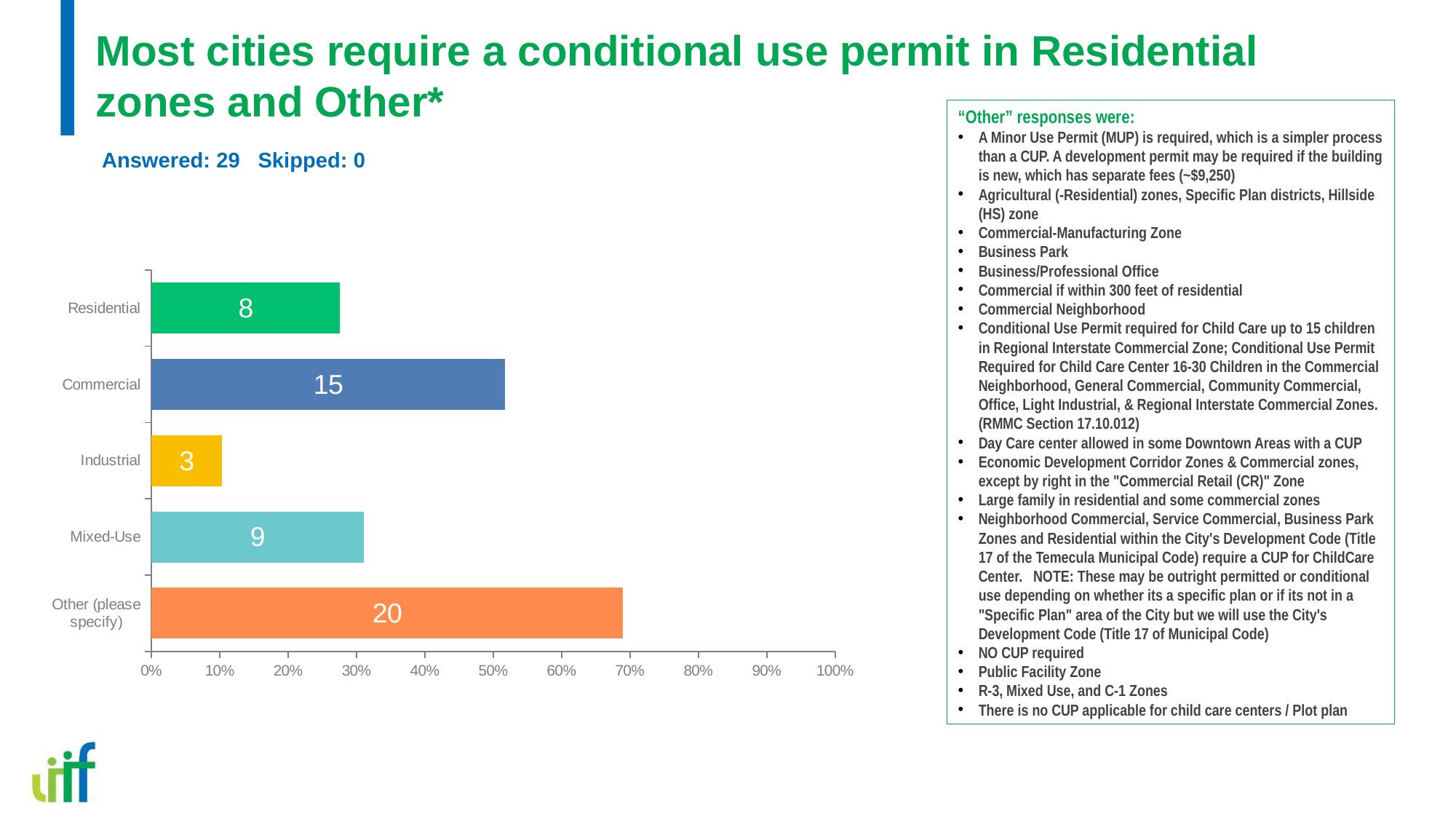
Is the Industrial bar greater or less than 20% on the axis? less What is the data label on the Commercial bar? 15 Is the Commercial bar greater or less than 50% on the axis? greater Which category has the lowest value? Industrial What is the difference between the Commercial and Residential data labels? 7 What is the data label on the Industrial bar? 3 What kind of chart is shown on the slide? Bar chart How many categories are shown in the chart? 5 Which category has the highest value? Other (please specify) Which is larger, the Mixed-Use bar or the Residential bar? Mixed-Use What is the data label on the Residential bar? 8 What is the data label on the Mixed-Use bar? 9